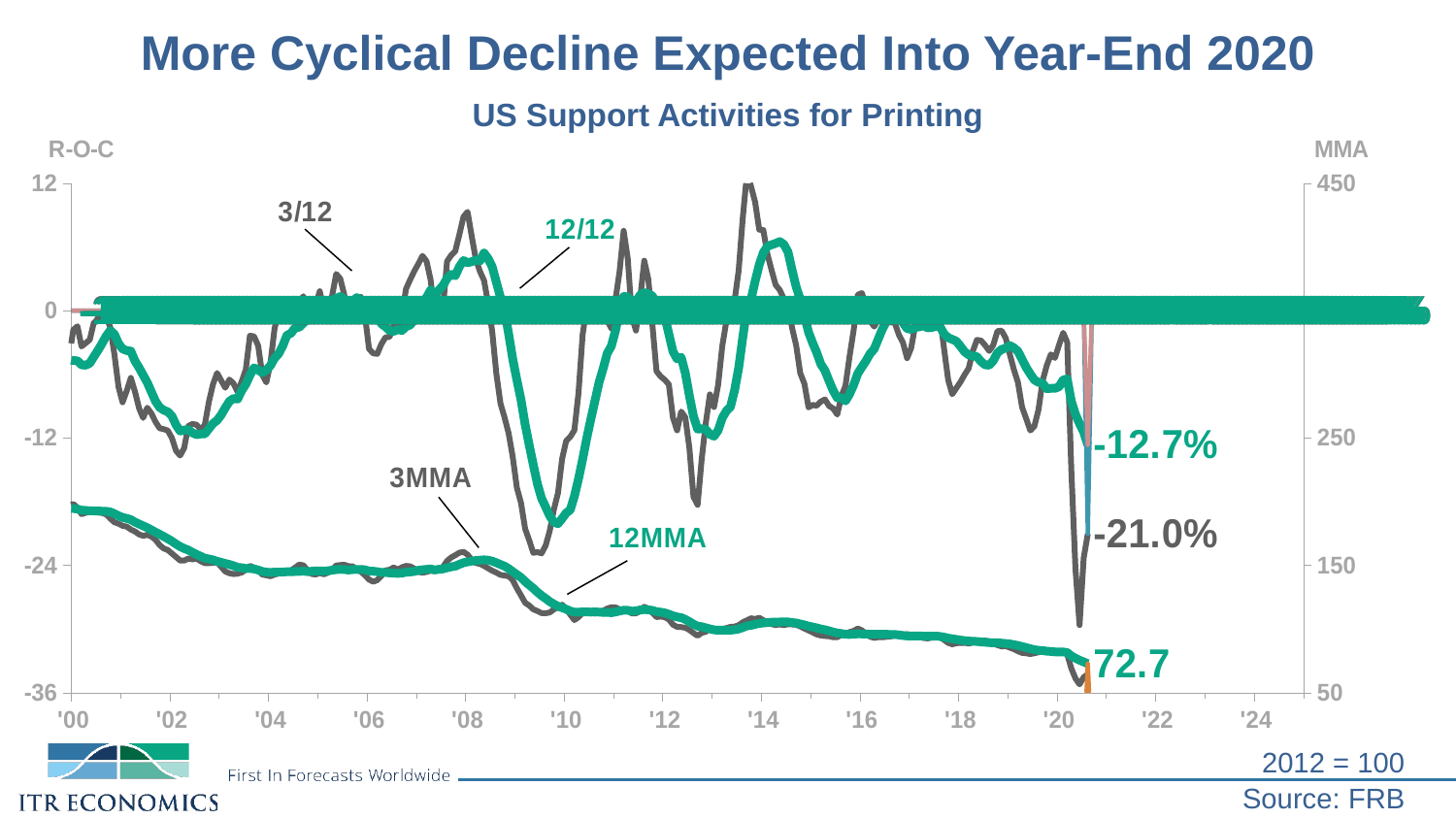
How many data series are labeled on the chart? 4 What kind of chart is shown on the slide? line chart Does the 12MMA line rise or fall overall from 2000 to 2020? fall What is the latest value shown for the 3/12 rate-of-change line? -21.0% What is the title of the chart? US Support Activities for Printing Which is lower at the end of the data, the 3/12 value or the 12/12 value? 3/12 (-21.0%) What is the latest value shown for the 12MMA line? 72.7 What is the difference between the latest 12/12 value (-12.7%) and the latest 3/12 value (-21.0%)? 8.3 percentage points Is the 12MMA value in 2000 greater or less than 150 on the right-hand axis? greater What is the lowest tick value on the left-hand R-O-C axis? -36 What is the highest tick value on the right-hand MMA axis? 450 What is the latest value shown for the 12/12 rate-of-change line? -12.7%